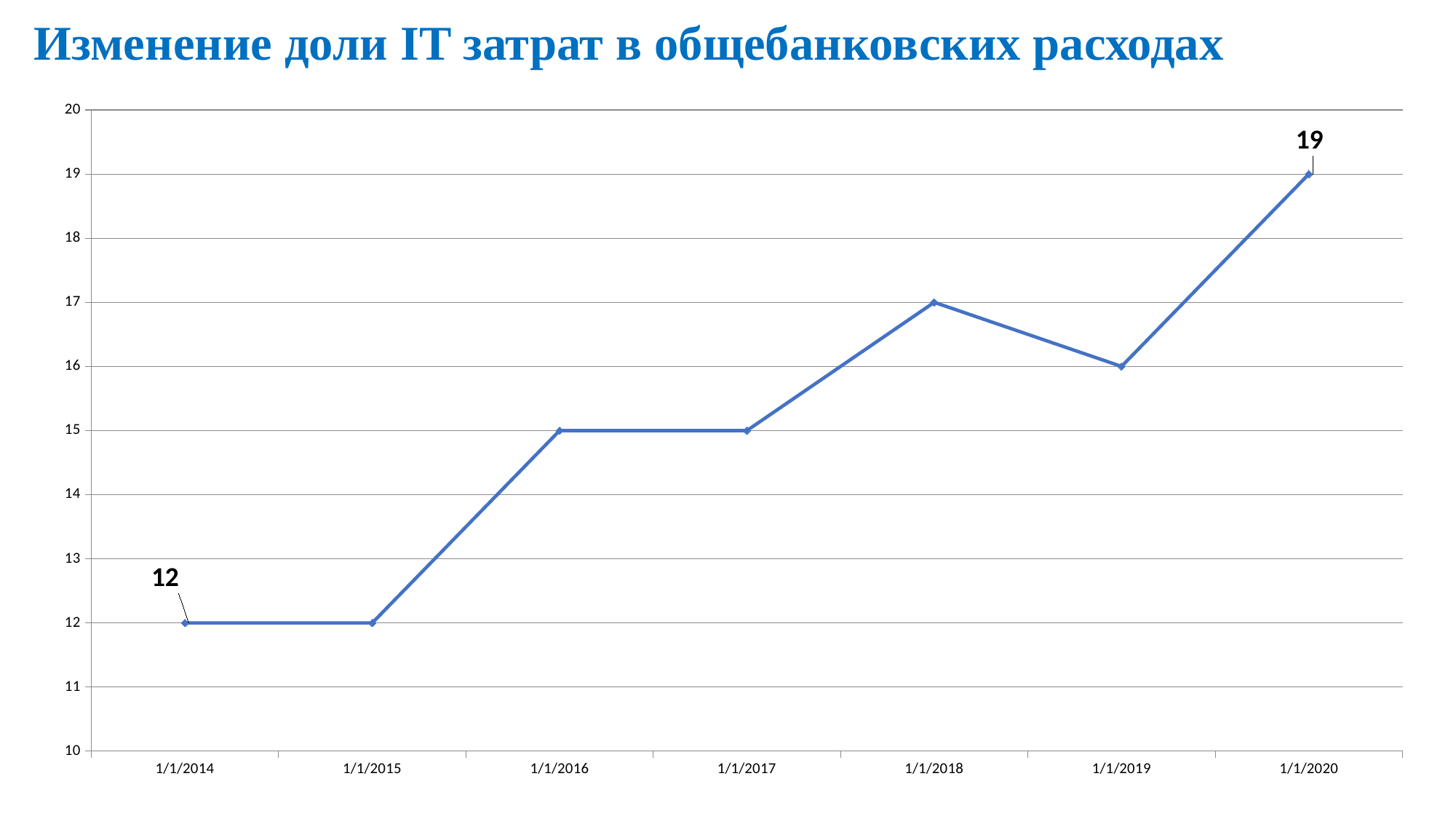
Which is larger, the value for 1/1/2018 or the value for 1/1/2019? 1/1/2018 How many data points are plotted on the chart? 7 Which date has the highest value? 1/1/2020 What is the title of the slide? Изменение доли IT затрат в общебанковских расходах Does the value rise or fall from 1/1/2019 to 1/1/2020? rise What type of chart is shown on the slide? line chart What is the value for 1/1/2018? 17 What is the value for 1/1/2014? 12 Is the value for 1/1/2019 greater or less than 15? greater What is the value for 1/1/2020? 19 What is the difference between the values for 1/1/2020 and 1/1/2014? 7 What is the value for 1/1/2016? 15